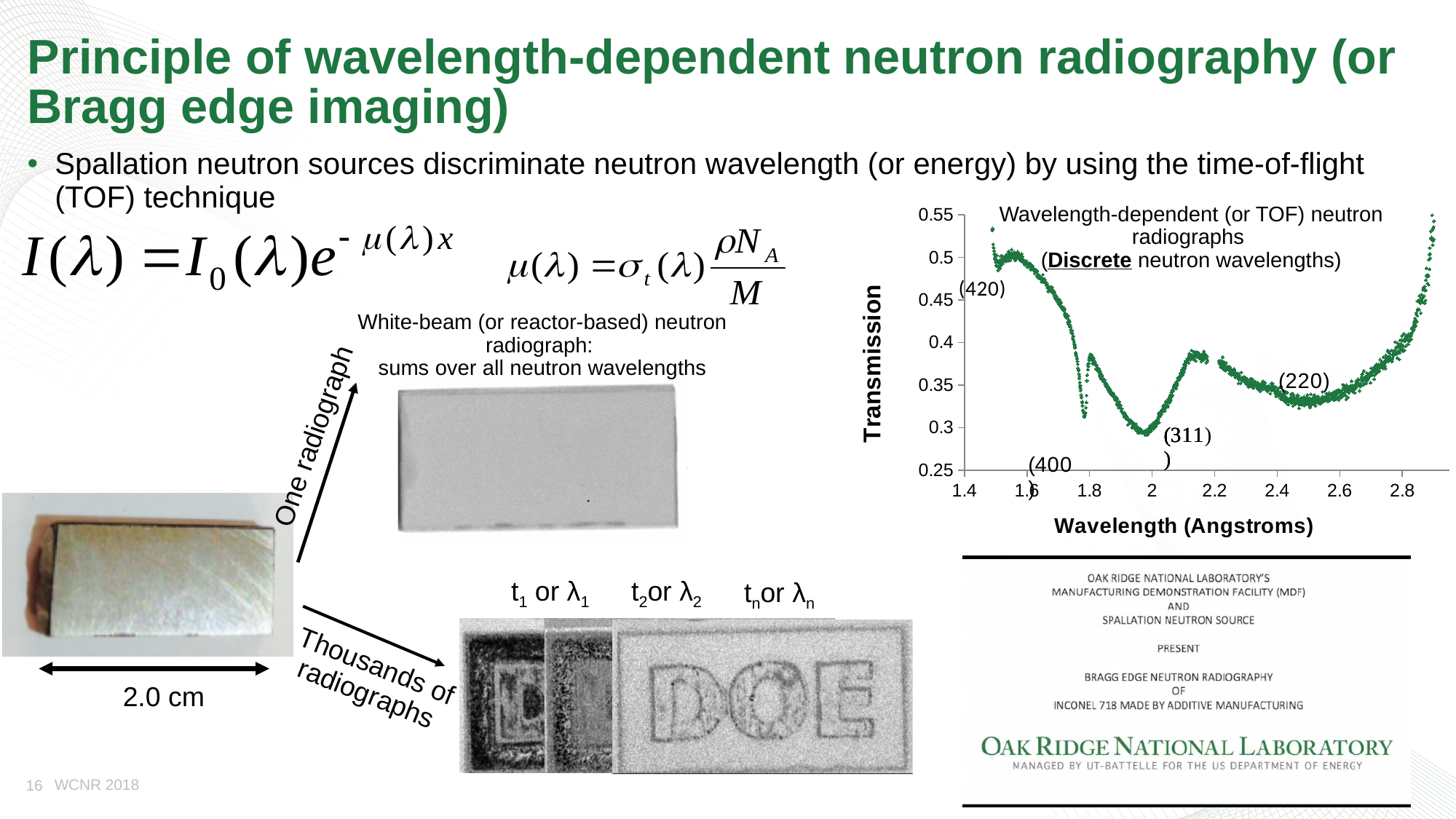
Is the transmission at a wavelength of 2.2 Angstroms greater or less than 0.3? greater Which has the lower transmission: the point at 2.0 Angstroms or the point at 2.8 Angstroms? 2.0 Angstroms Which has the higher transmission: the point at 1.5 Angstroms or the point at 2.0 Angstroms? 1.5 Angstroms Is the transmission at a wavelength of 1.5 Angstroms greater or less than 0.45? greater What is the title of the y axis of the Transmission chart? Transmission Does the transmission rise or fall as the wavelength increases from 1.6 to 2.0 Angstroms? fall Does the transmission rise or fall as the wavelength increases from 2.5 to 2.9 Angstroms? rise What kind of chart is used to show Transmission versus Wavelength? Scatter chart Is the transmission at a wavelength of 2.8 Angstroms greater or less than 0.4? greater What is the title of the x axis of the Transmission chart? Wavelength (Angstroms)